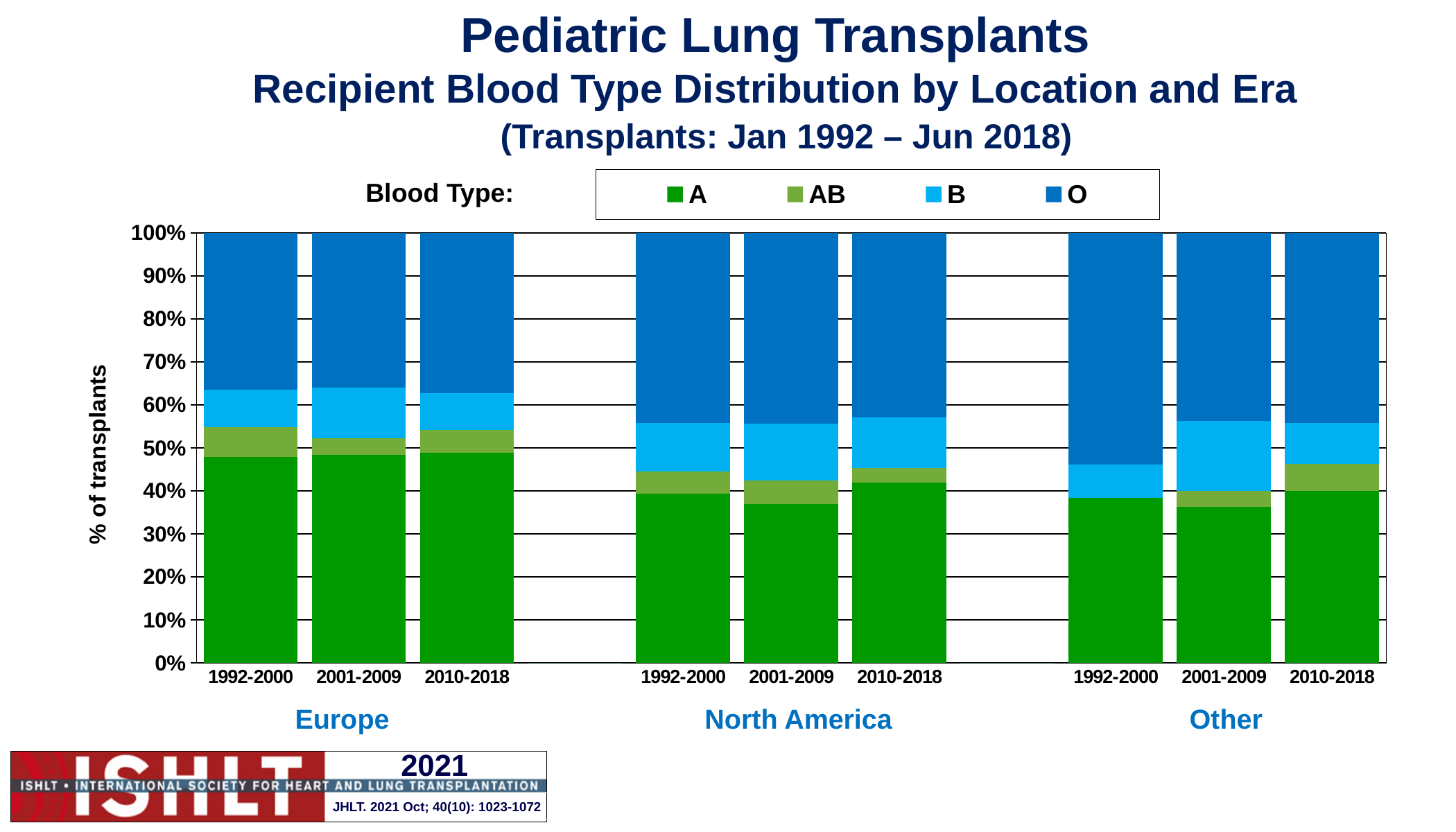
How many bars are plotted in the chart? 9 How many blood type series does the legend list? 4 How many location groups are shown along the x axis? 3 Is the share of blood type A recipients for Europe 1992-2000 greater or less than 40%? greater What does each stacked bar total? 100% Is the share of blood type A recipients for Other 2001-2009 greater or less than 40%? less Which location and era has the largest share of blood type O recipients? Other, 1992-2000 Which colour represents blood type AB in the legend? Light green Which has a larger share of blood type A recipients: Europe 2010-2018 or Other 2001-2009? Europe 2010-2018 What is the label on the y axis? % of transplants What kind of chart is shown on the slide? Stacked bar chart Is the share of blood type A recipients for North America 2001-2009 greater or less than 40%? less